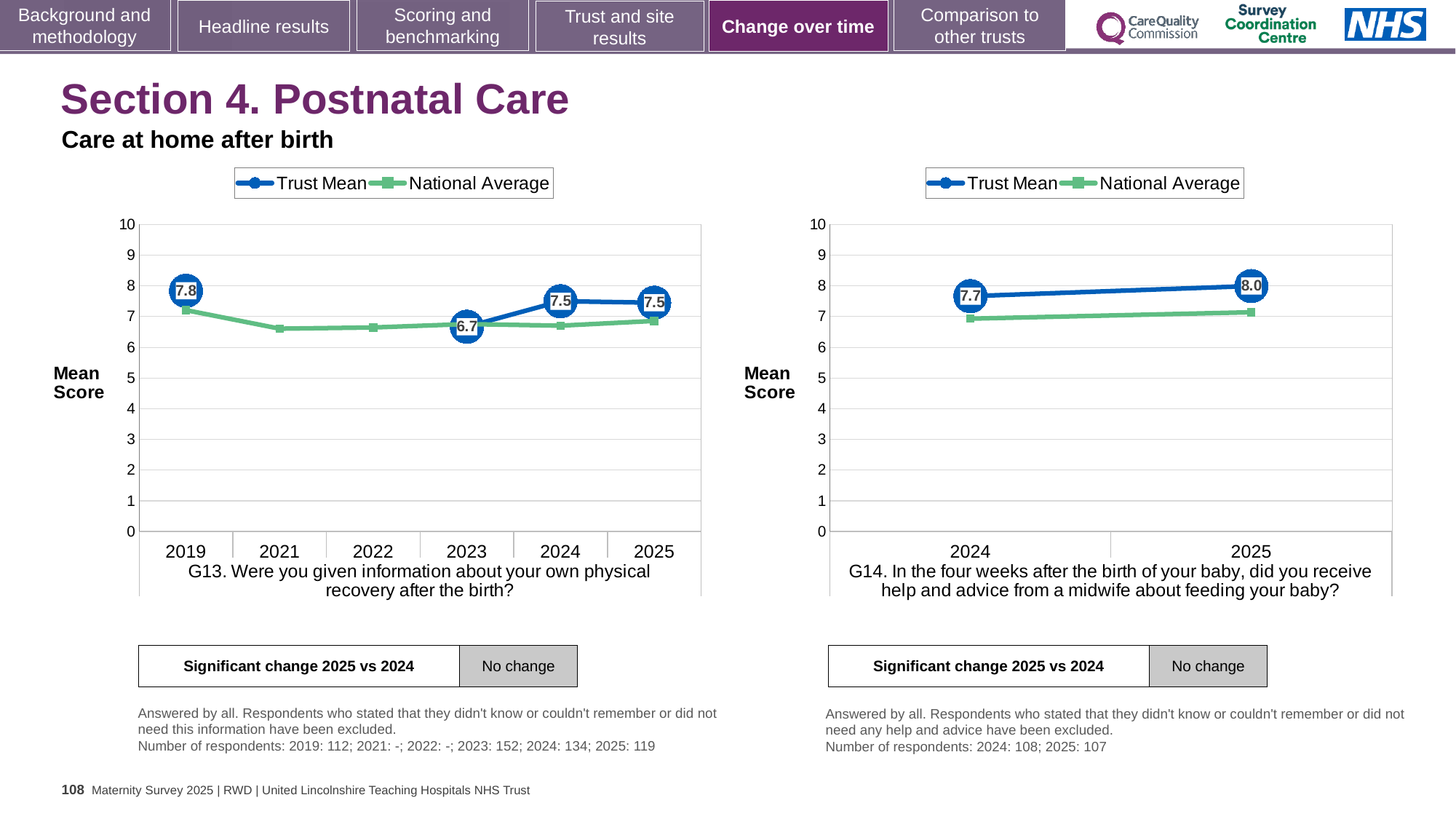
In the G14 chart on the right, what is the Trust Mean score for 2025? 8.0 In the G13 chart on the left, what is the Trust Mean score for 2023? 6.7 What kind of chart is the G14 chart on the right? line chart How many years are shown on the x axis of the G13 chart on the left? 6 In the G13 chart on the left, what is the Trust Mean score for 2019? 7.8 In the G13 chart on the left, which year has the lowest Trust Mean score? 2023 In the G14 chart on the right, what is the Trust Mean score for 2024? 7.7 In the G14 chart on the right, which is larger in 2025: the Trust Mean or the National Average? Trust Mean In the G14 chart on the right, what is the difference between the Trust Mean scores for 2025 and 2024? 0.3 In the G13 chart on the left, what is the difference between the Trust Mean scores for 2019 and 2023? 1.1 In the G13 chart on the left, which year has the highest Trust Mean score? 2019 In the G13 chart on the left, is the National Average value for 2021 greater or less than 7? less